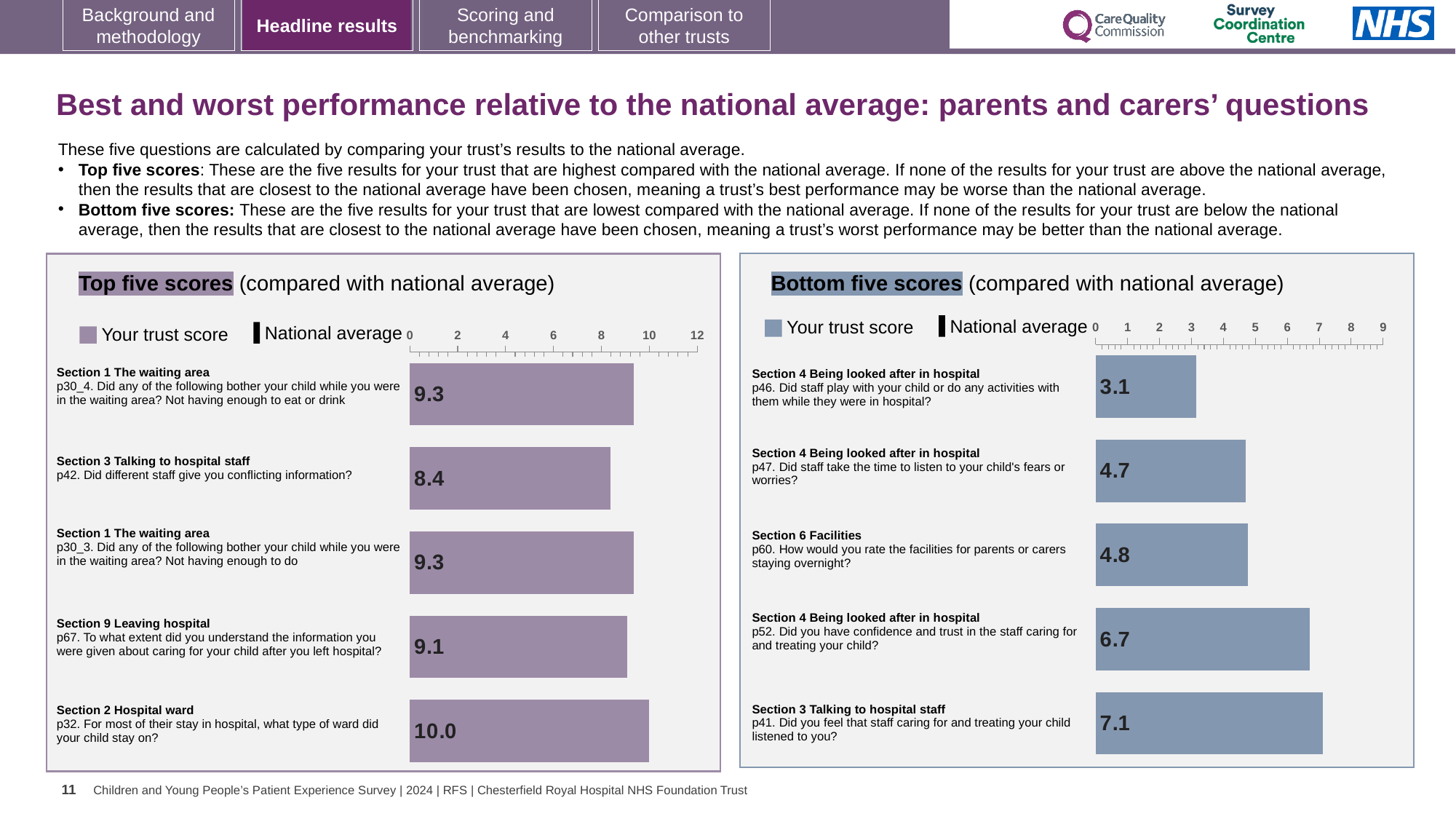
In the Bottom five scores chart, what is the trust score for p46 (Did staff play with your child or do any activities with them while they were in hospital?)? 3.1 In the Bottom five scores chart, is the trust score for p46 greater or less than 4? less In the Bottom five scores chart, which question has the lowest trust score? p46. Did staff play with your child or do any activities with them while they were in hospital? In the Top five scores chart, which question has the highest trust score? p32. For most of their stay in hospital, what type of ward did your child stay on? In the Bottom five scores chart, which has the larger trust score: p47 or p52? p52 In the Bottom five scores chart, what is the trust score for p52 (Did you have confidence and trust in the staff caring for and treating your child?)? 6.7 In the Top five scores chart, what is the difference between the trust scores for p32 and p42? 1.6 How many series does the legend of the Bottom five scores chart list? 2 How many questions are shown in the Top five scores chart? 5 In the Top five scores chart, what is the trust score for p42 (Did different staff give you conflicting information?)? 8.4 In the Bottom five scores chart, what is the difference between the trust scores for p41 and p46? 4.0 In the Top five scores chart, what is the trust score for p32 (For most of their stay in hospital, what type of ward did your child stay on?)? 10.0